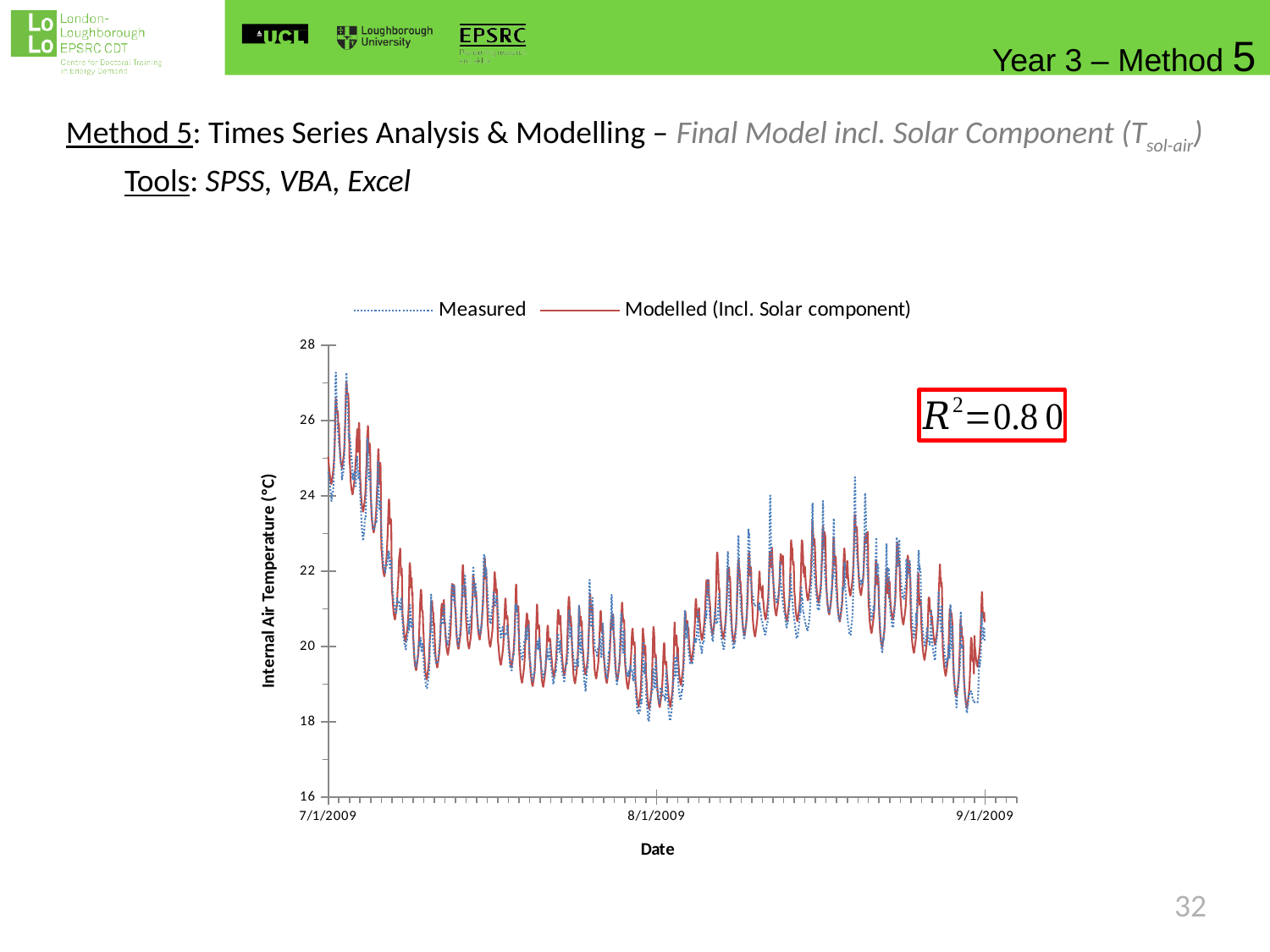
Is the Measured temperature at any point in the chart greater or less than 28? less What is the first date label shown on the chart's x axis? 7/1/2009 Is the highest Measured temperature near the start of July 2009 greater or less than 26? greater Is the lowest Measured temperature around 8/1/2009 greater or less than 20? less What is the last date label shown on the chart's x axis? 9/1/2009 How many series does the chart's legend list? 2 What R² value is annotated on the chart? R²=0.80 How many date labels are printed along the chart's x axis? 3 Do the temperatures generally rise or fall between 7/1/2009 and 8/1/2009? fall What are the two series named in the chart's legend? Measured; Modelled (Incl. Solar component) What kind of chart is shown on the slide? Line chart What is the title of the chart's vertical axis? Internal Air Temperature (°C)